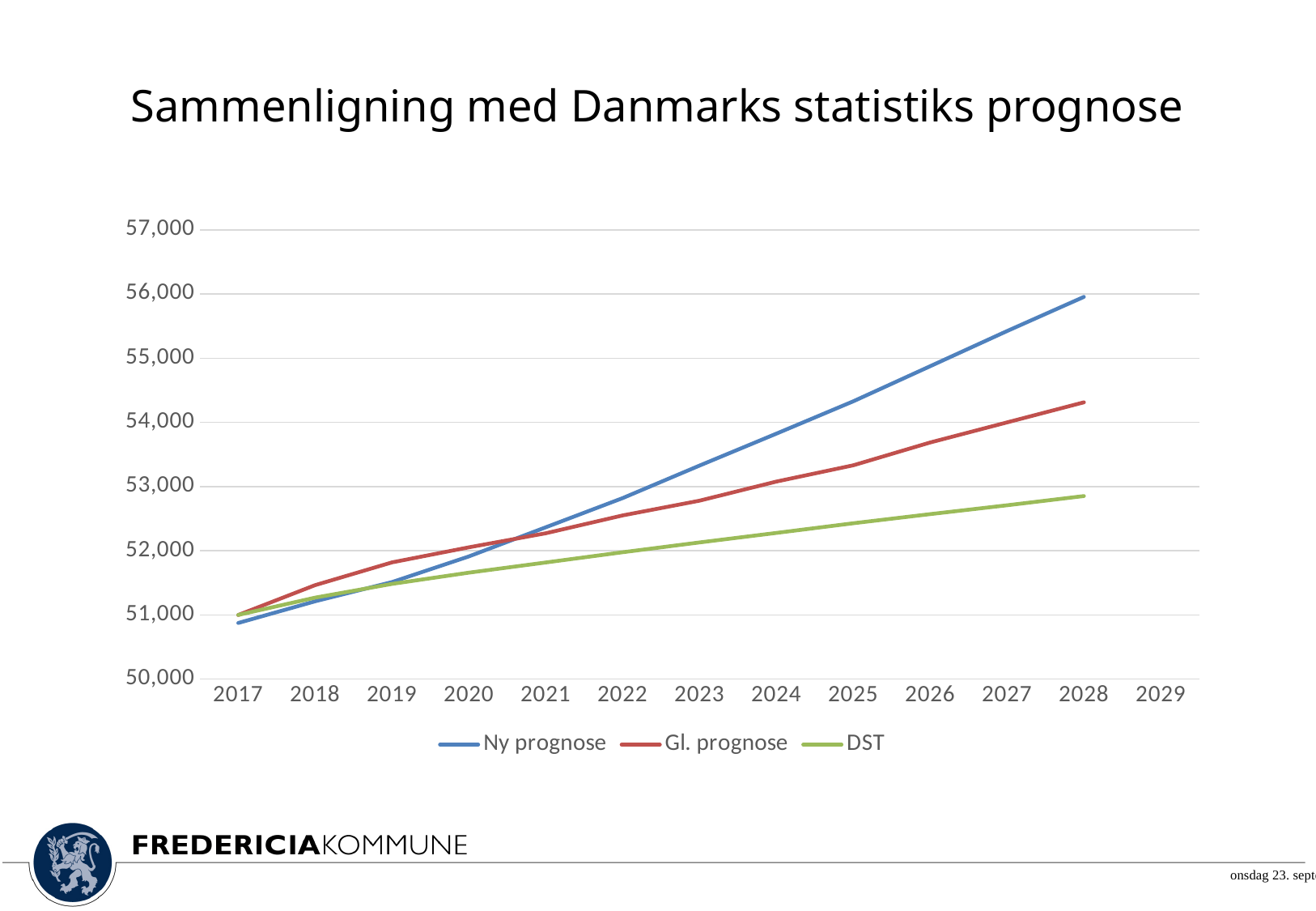
In 2019, which is larger: Gl. prognose or Ny prognose? Gl. prognose Which series has the highest value in 2028? Ny prognose Is the value for Gl. prognose in 2028 greater or less than 54,000? greater How many year labels are shown on the x axis? 13 What is the title of the chart? Sammenligning med Danmarks statistiks prognose Is the value for DST in 2028 greater or less than 53,000? less Is the value for Ny prognose in 2028 greater or less than 55,000? greater Which series has the lowest value in 2028? DST Does the Ny prognose line rise or fall from 2017 to 2028? rise What kind of chart is shown on the slide? line chart How many series does the legend list? 3 Which series is drawn in green? DST